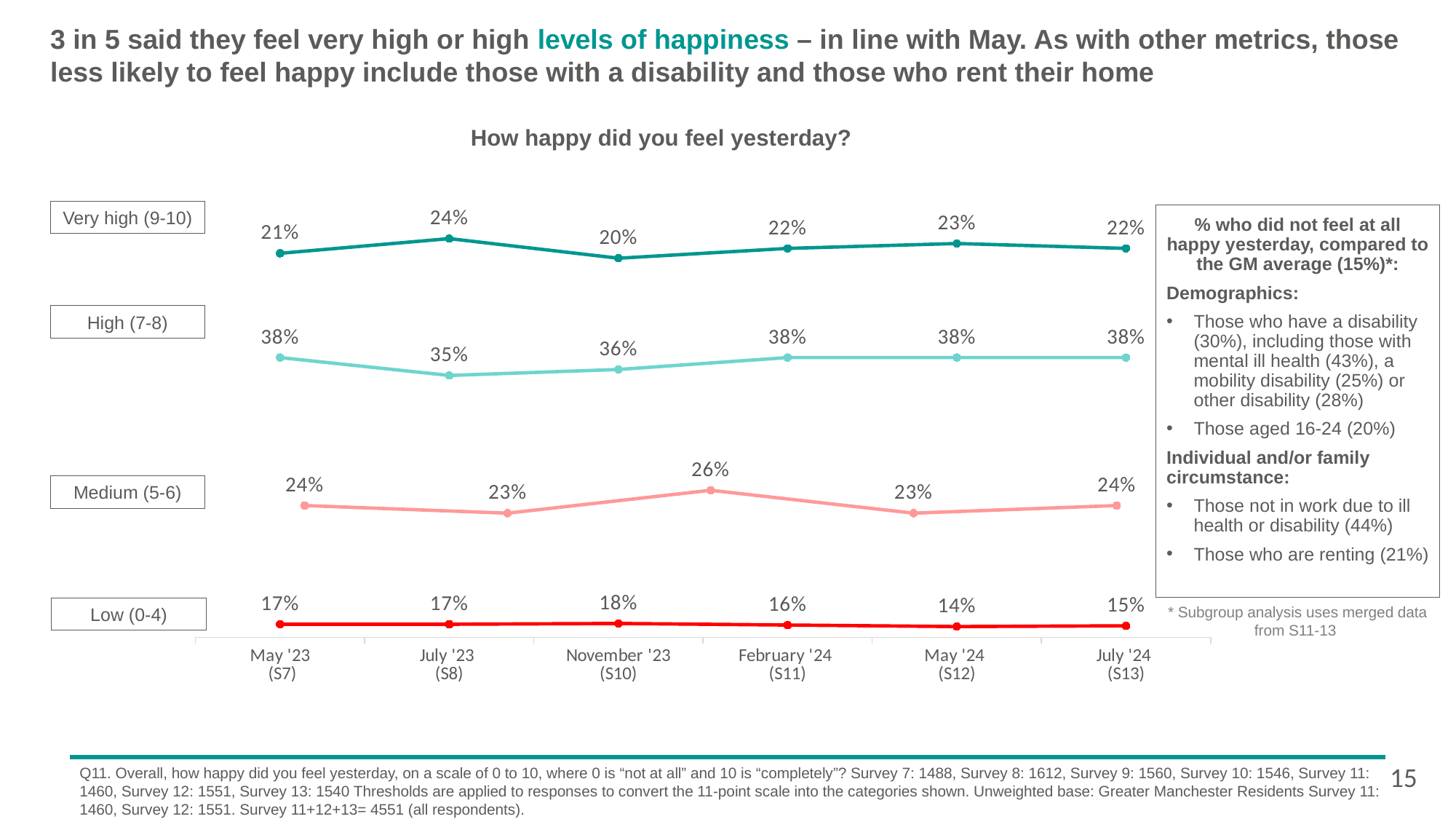
What percentage felt Low (0-4) happiness in May '24 (S12)? 14% What type of chart is shown on the slide? line chart Which was larger in May '23 (S7): the Medium (5-6) value or the Low (0-4) value? Medium (5-6) In which survey wave was the Low (0-4) value highest? November '23 (S10) What is the title of the chart? How happy did you feel yesterday? What percentage felt High (7-8) happiness in July '23 (S8)? 35% What percentage felt Very high (9-10) happiness in July '23 (S8)? 24% What percentage felt Medium (5-6) happiness in November '23 (S10)? 26% In which survey wave was the Very high (9-10) value lowest? November '23 (S10) How many series (happiness categories) are plotted on the chart? 4 How many time points are shown on the x axis of the chart? 6 What is the difference between the High (7-8) value and the Very high (9-10) value in July '24 (S13)? 16 percentage points